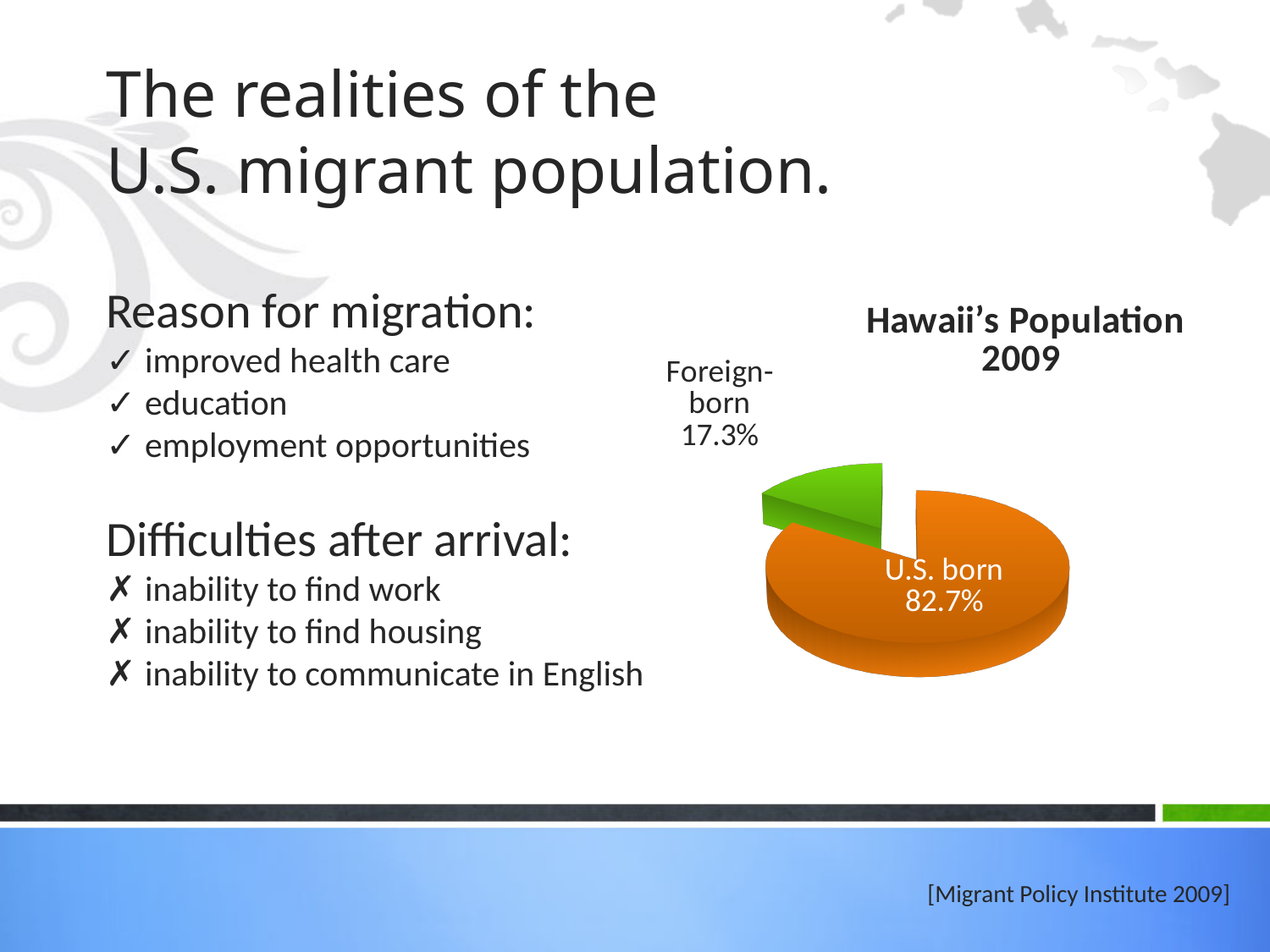
Which slice of the pie is the largest? U.S. born What colour is the foreign-born slice? Green What is the total of the two slices shown in the pie chart? 100% Which is larger, the U.S. born share or the foreign-born share? U.S. born What is the title of the chart? Hawaii's Population 2009 What kind of chart is shown on the slide? Pie chart What share of Hawaii's population in 2009 is U.S. born? 82.7% How many slices does the pie chart have? 2 What share of Hawaii's population in 2009 is foreign-born? 17.3% What is the difference in percentage points between the U.S. born and foreign-born shares? 65.4 Which slice of the pie is the smallest? Foreign-born